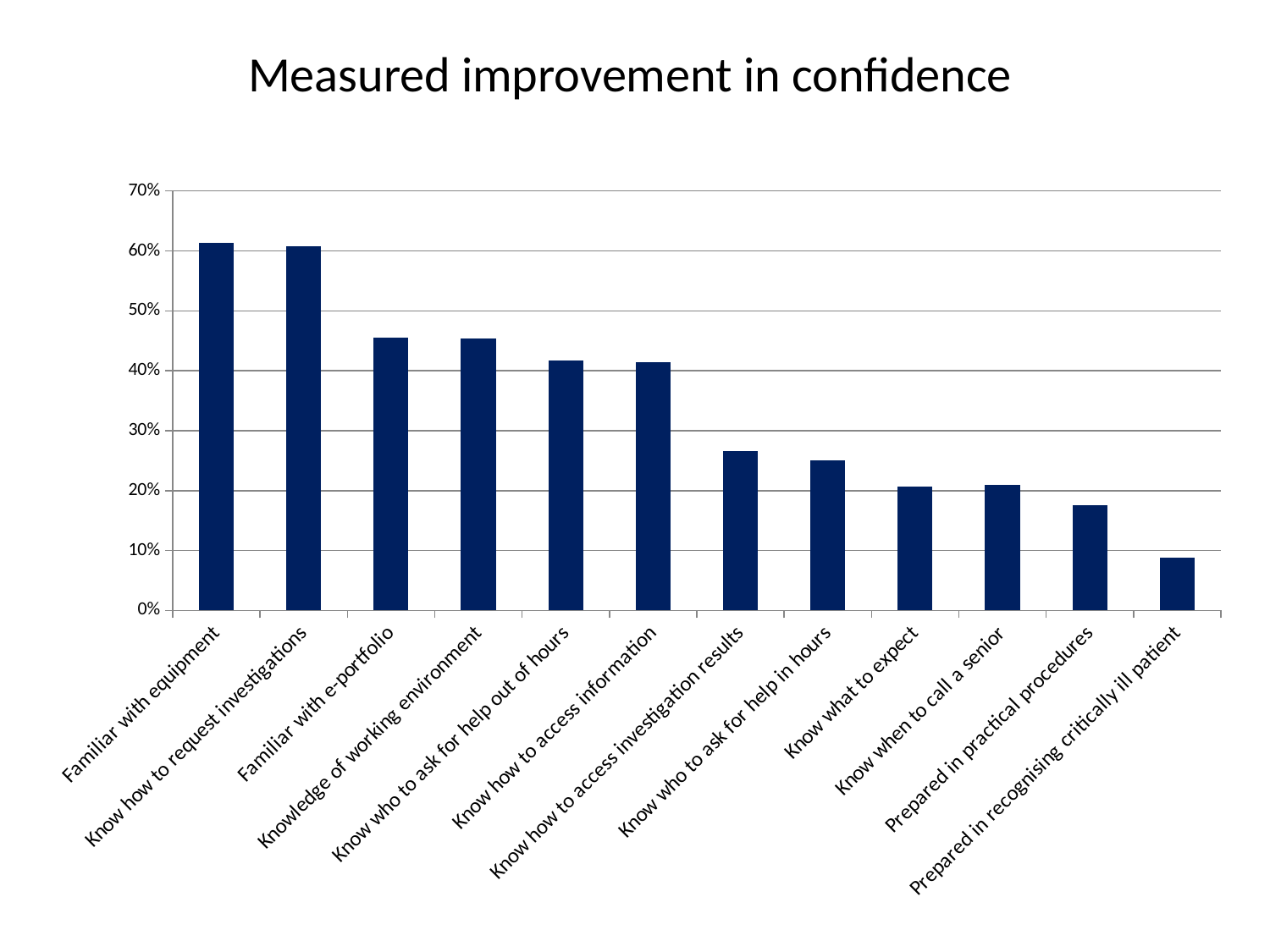
Is the value for Know how to access investigation results greater or less than 30%? less What is the title of the chart? Measured improvement in confidence Which category has the lowest value? Prepared in recognising critically ill patient Which is larger: the value for Know who to ask for help in hours or the value for Prepared in practical procedures? Know who to ask for help in hours How many categories are plotted in the chart? 12 Is the value for Familiar with equipment greater or less than 50%? greater What kind of chart is shown on the slide? bar chart Do the values generally rise or fall moving from left to right along the x axis? fall Is the value for Prepared in recognising critically ill patient greater or less than 10%? less Which is larger: the value for Familiar with e-portfolio or the value for Know how to access investigation results? Familiar with e-portfolio